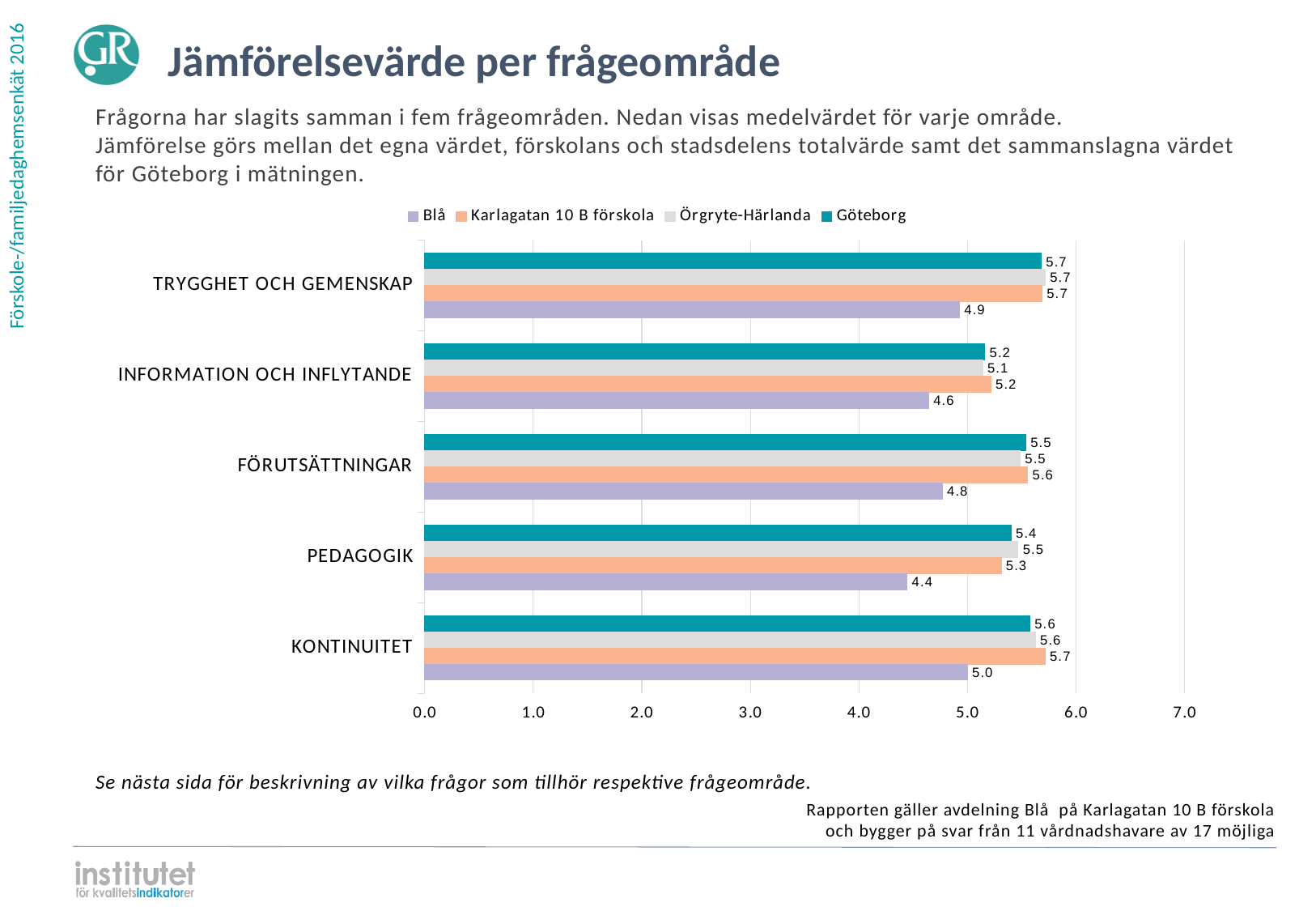
What is the value for Blå in the category PEDAGOGIK? 4.4 What is the difference between the Göteborg value and the Blå value in TRYGGHET OCH GEMENSKAP? 0.8 How many series does the legend list? 4 In which category does Blå have its highest value? KONTINUITET What is the value for Göteborg in the category INFORMATION OCH INFLYTANDE? 5.2 Which series is shown in teal in the legend? Göteborg In which category does Blå have its lowest value? PEDAGOGIK In PEDAGOGIK, which is larger: the value for Örgryte-Härlanda or the value for Karlagatan 10 B förskola? Örgryte-Härlanda What is the value for Karlagatan 10 B förskola in the category KONTINUITET? 5.7 What is the value for Örgryte-Härlanda in the category FÖRUTSÄTTNINGAR? 5.5 What type of chart is shown on the slide? Bar chart How many question areas (categories) are shown on the chart? 5